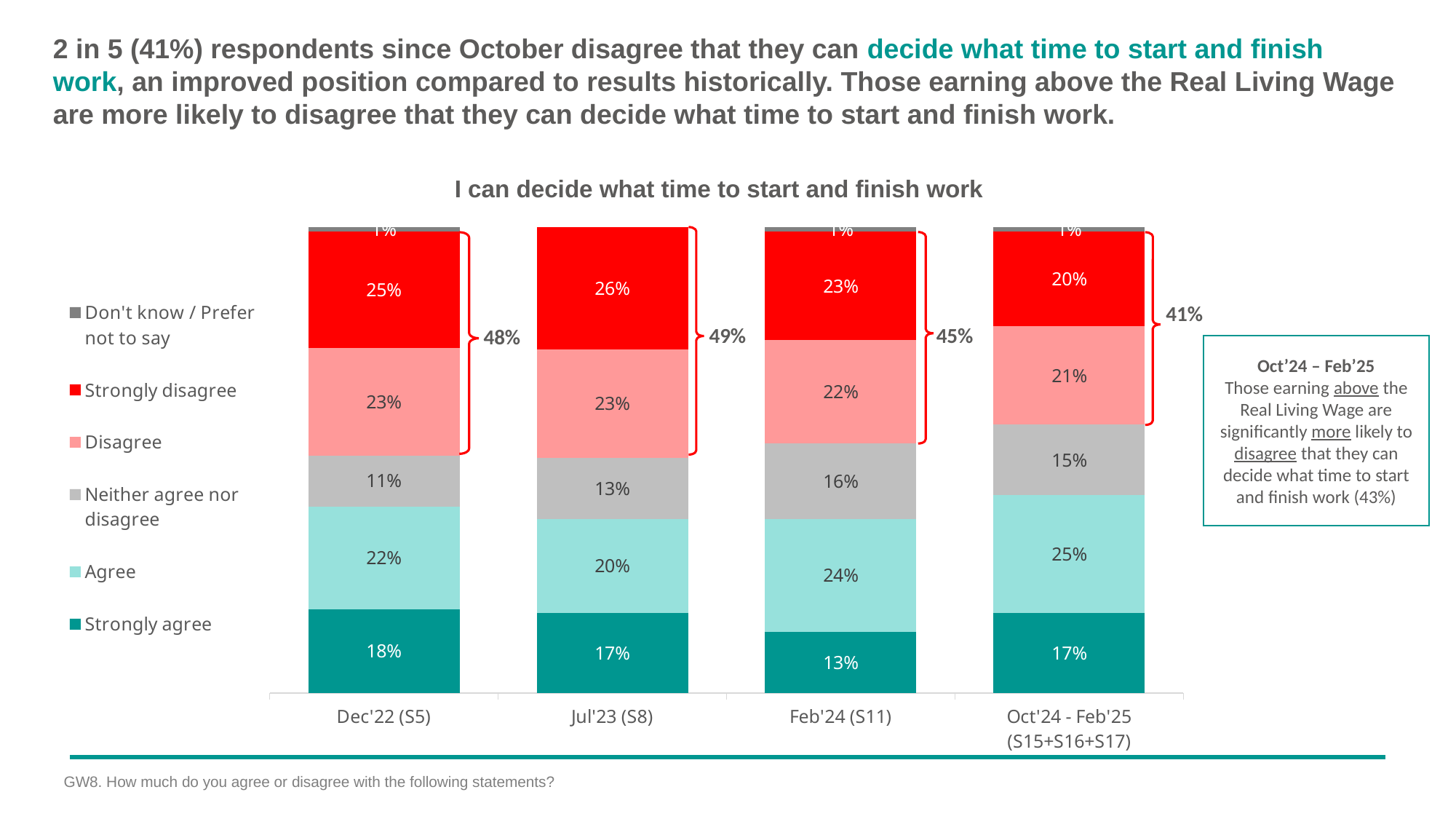
What is the Strongly agree value for Feb'24 (S11)? 13% What is the Neither agree nor disagree value for Oct'24 - Feb'25 (S15+S16+S17)? 15% Which period has the lowest Strongly agree value? Feb'24 (S11) Which period has the highest Agree value? Oct'24 - Feb'25 (S15+S16+S17) What is the Strongly disagree value for Jul'23 (S8)? 26% What is the difference between the Strongly disagree values for Jul'23 (S8) and Oct'24 - Feb'25 (S15+S16+S17)? 6% What kind of chart is shown on the slide? Stacked bar chart Which is larger: the Disagree value for Dec'22 (S5) or the Disagree value for Oct'24 - Feb'25 (S15+S16+S17)? Dec'22 (S5) How many time periods (bars) are shown on the x axis? 4 How many series does the legend list? 6 What is the chart's title? I can decide what time to start and finish work What is the combined Disagree and Strongly disagree total shown by the bracket for Feb'24 (S11)? 45%